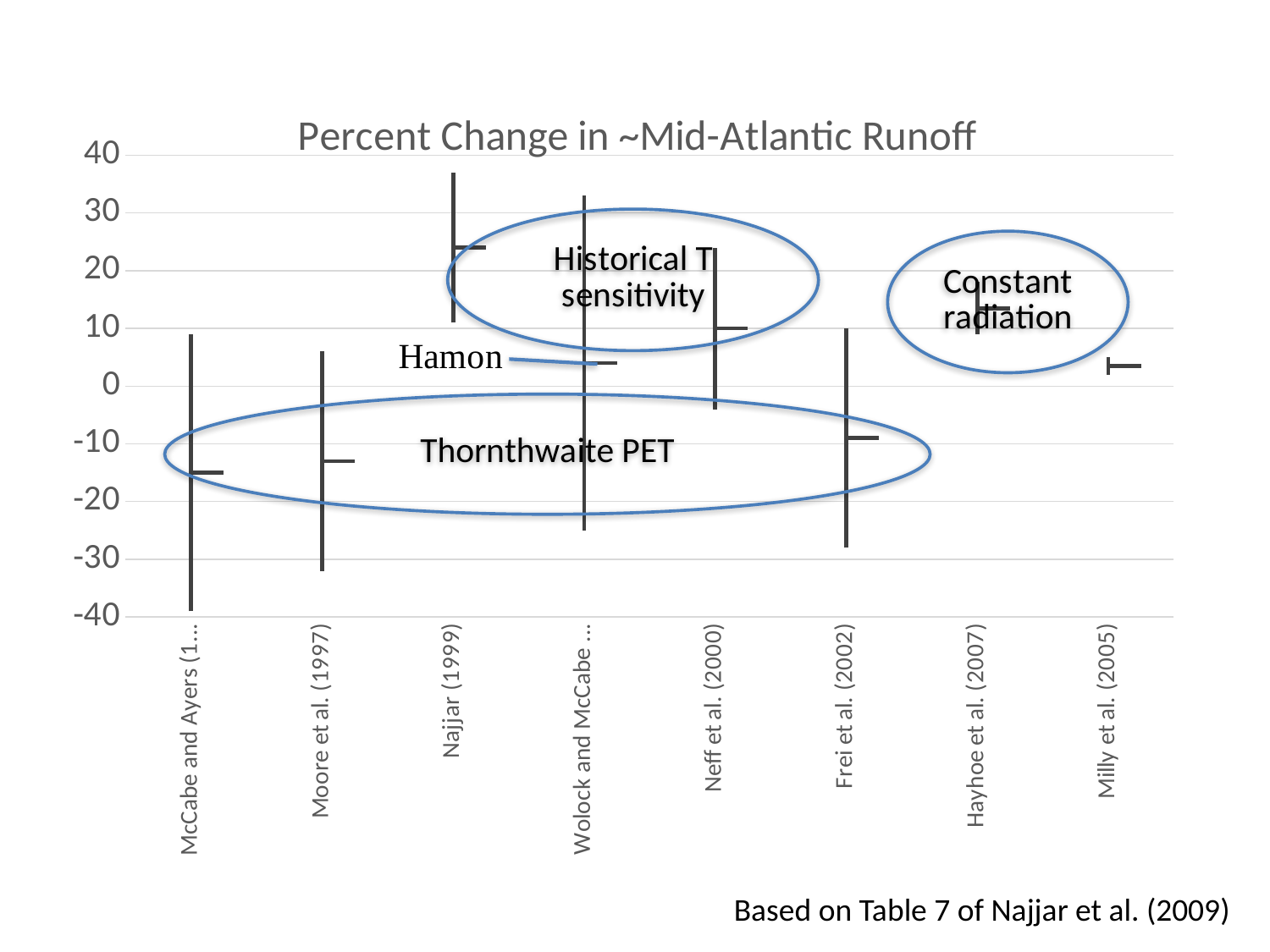
Is the value for Wolock and McCabe greater or less than 0? greater Is the value for Milly et al. (2005) greater or less than 0? greater What is the highest value shown on the y axis? 40 Which study has the highest plotted value? Najjar (1999) What is the title of the chart? Percent Change in ~Mid-Atlantic Runoff Is the value for Najjar (1999) greater or less than 20? greater Which group label is written inside the large ellipse in the lower part of the chart? Thornthwaite PET Which is larger, the value for Najjar (1999) or the value for Moore et al. (1997)? Najjar (1999) Which is larger, the value for Hayhoe et al. (2007) or the value for Frei et al. (2002)? Hayhoe et al. (2007) How many studies (categories) are plotted along the x axis? 8